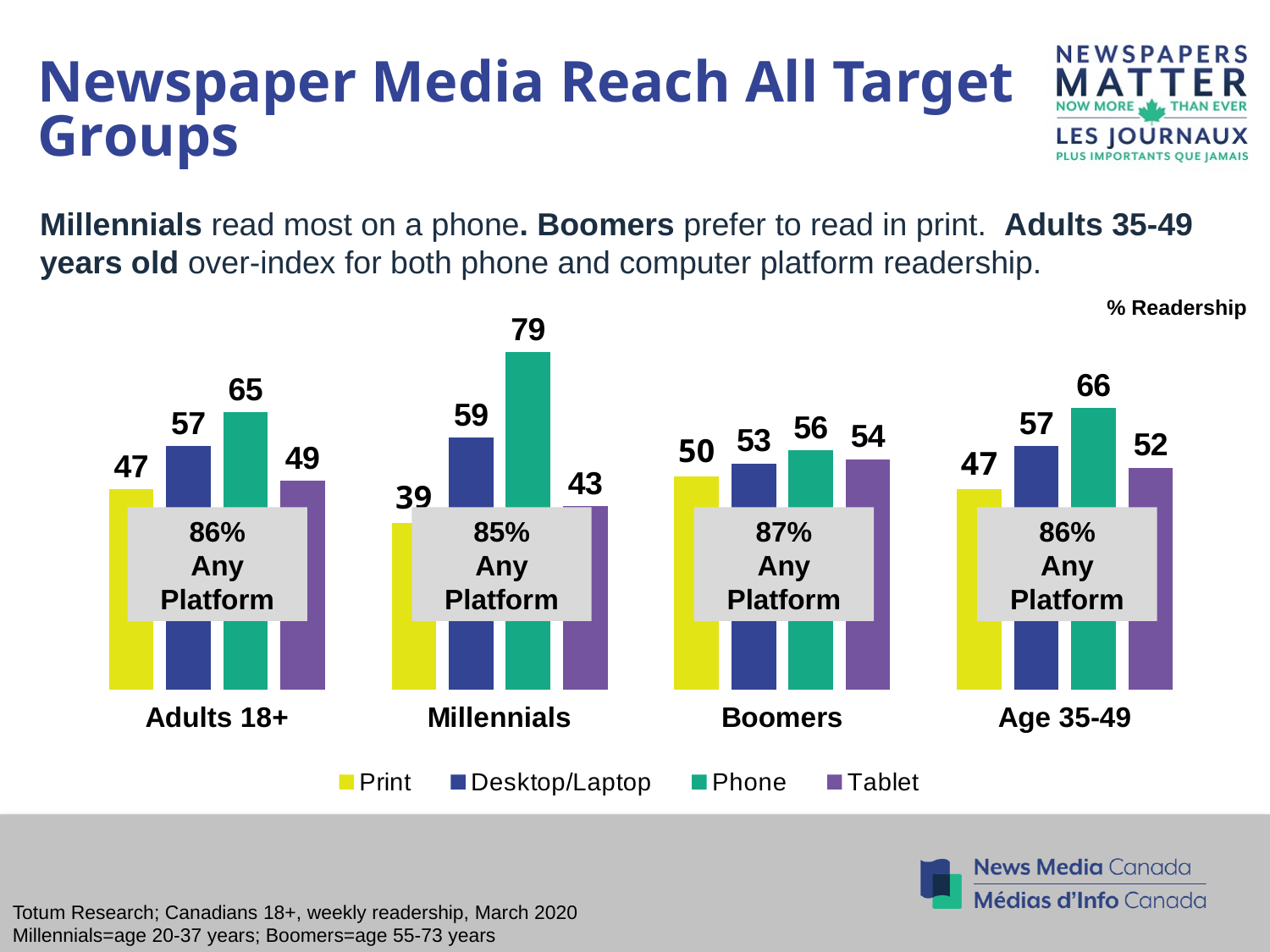
What is the Tablet readership value for Age 35-49? 52 Which platform has the lowest readership among Adults 18+? Print Which is larger for Boomers: Print readership or Tablet readership? Tablet What is the 'Any Platform' readership shown for Boomers? 87% What is the Phone readership value for Millennials? 79 What kind of chart is shown on the slide? Bar chart Which platform has the highest readership among Millennials? Phone How many series does the legend list? 4 What is the difference between Phone and Print readership for Millennials? 40 What is the Print readership value for Boomers? 50 How many age groups are shown on the x axis? 4 What is the Desktop/Laptop readership value for Adults 18+? 57